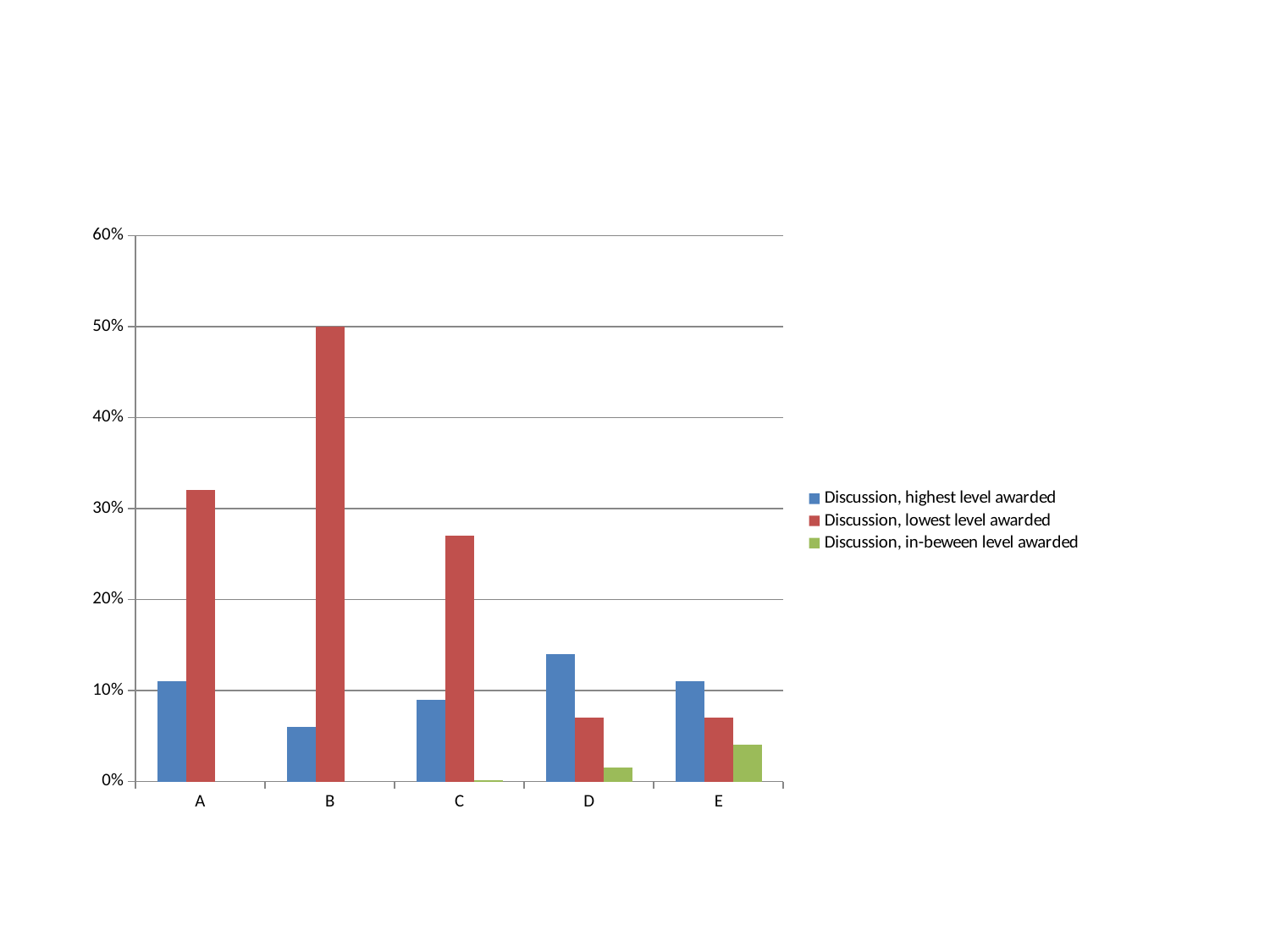
What kind of chart is shown on the slide? bar chart Which category has the highest value for 'Discussion, lowest level awarded'? B What is the value for 'Discussion, lowest level awarded' in category B? 50% In category D, which is larger: 'Discussion, highest level awarded' or 'Discussion, lowest level awarded'? Discussion, highest level awarded In category A, which is larger: 'Discussion, highest level awarded' or 'Discussion, lowest level awarded'? Discussion, lowest level awarded How many series does the legend list? 3 How many categories are shown on the x axis? 5 Is the value for 'Discussion, lowest level awarded' in category A greater or less than 30%? greater Is the value for 'Discussion, lowest level awarded' in category C greater or less than 20%? greater Is the value for 'Discussion, highest level awarded' in category B greater or less than 10%? less What colour are the bars for 'Discussion, in-beween level awarded'? green Which category has the highest value for 'Discussion, highest level awarded'? D